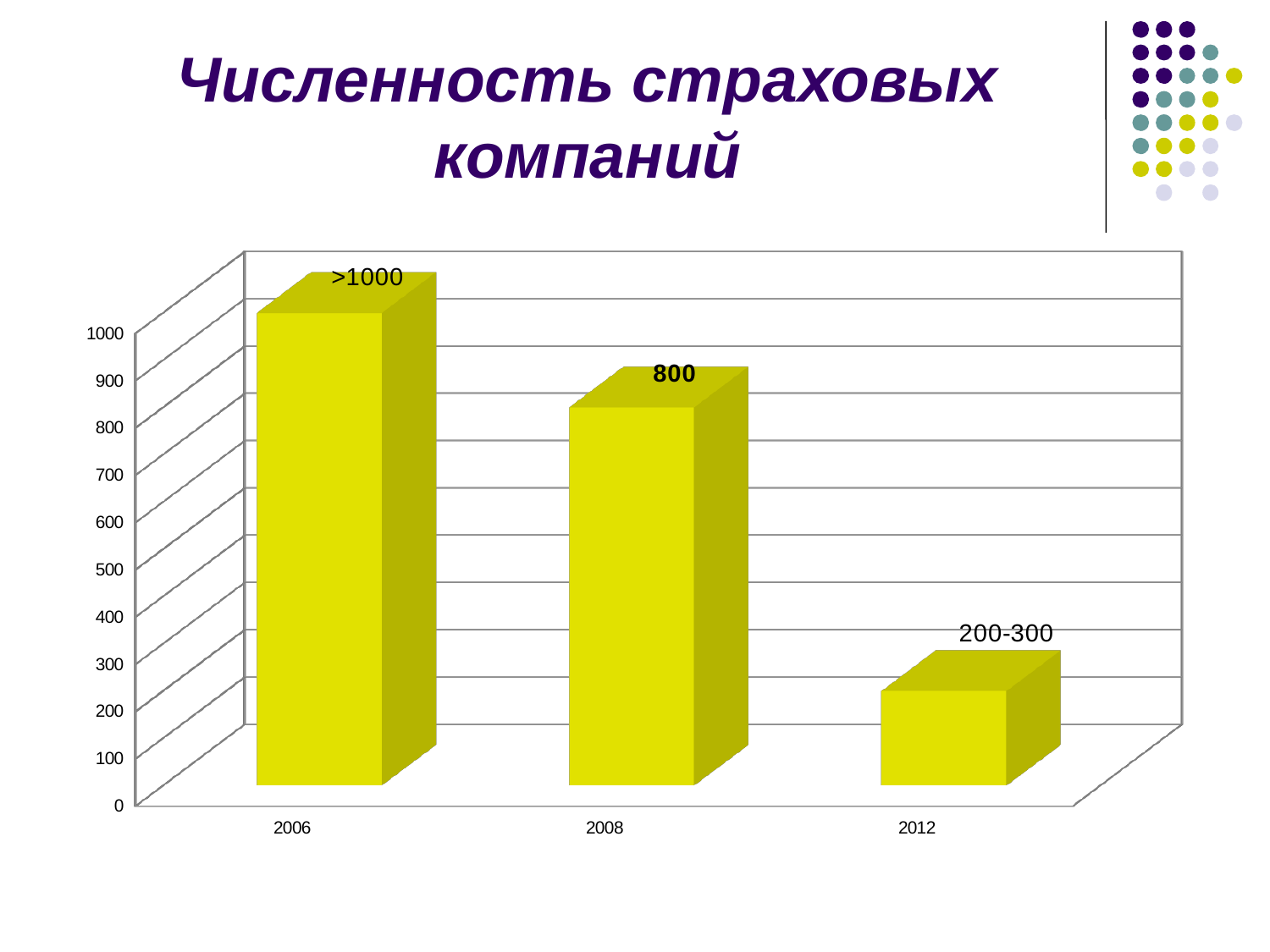
What is the value shown for 2008? 800 What kind of chart is shown on the slide? bar chart Which year has the lowest bar? 2012 Which year has the highest bar? 2006 How many years are shown on the x axis? 3 Do the values rise or fall from 2006 to 2012? fall What label is shown on the bar for 2006? >1000 Is the value for 2012 greater or less than 500? less What label is shown on the bar for 2012? 200-300 Is the value for 2008 greater or less than 500? greater Which is larger, the value for 2008 or the value for 2012? 2008 What is the title of the slide? Численность страховых компаний